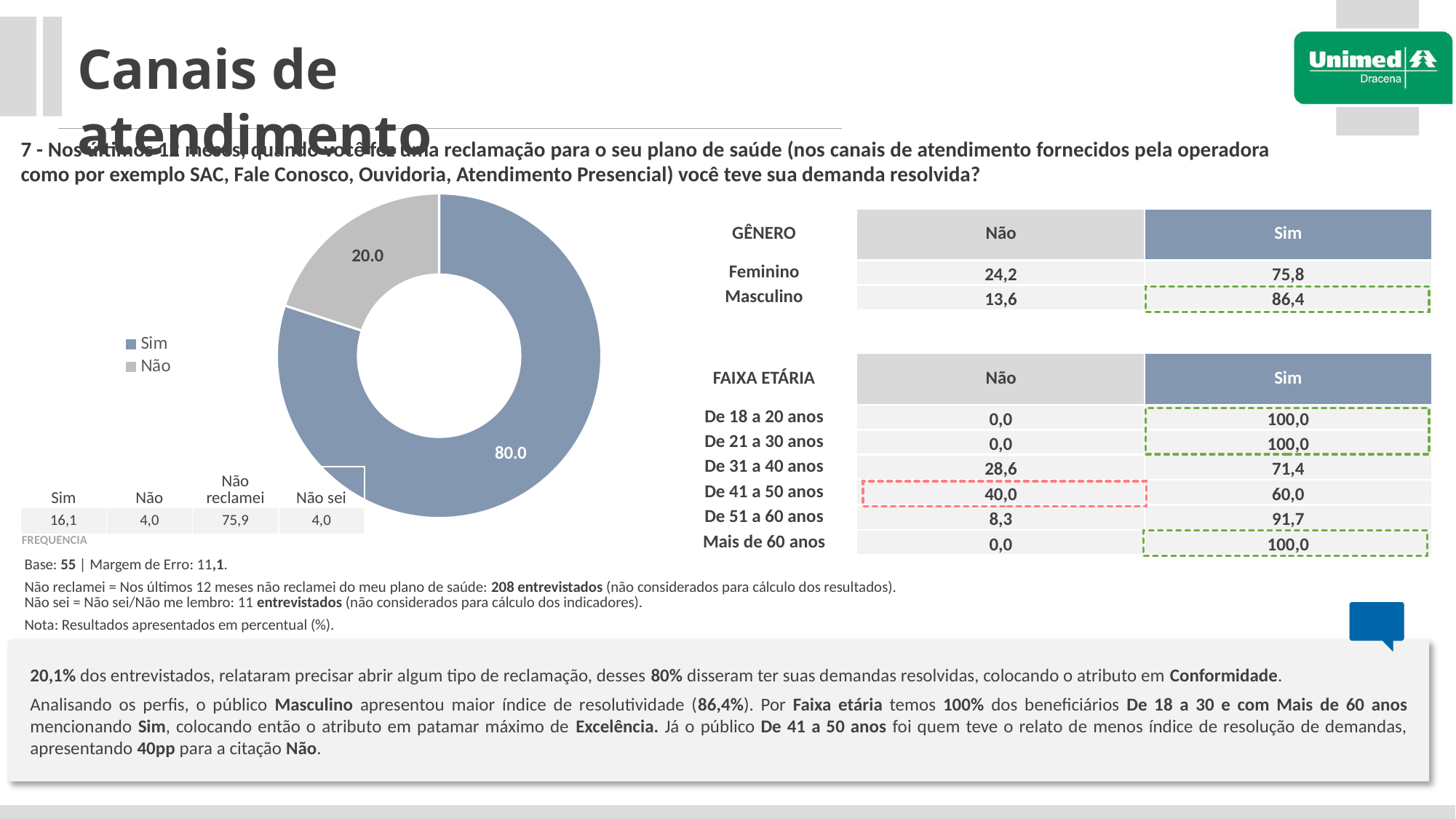
What is the difference between the Sim and Não values in the donut chart? 60.0 What is the value for Não in the donut chart? 20.0 What colour is the Sim slice in the donut chart? Blue-grey Which category has the smallest slice in the donut chart? Não What kind of chart is shown on the slide? Donut (pie) chart Which category has the largest slice in the donut chart? Sim What share of the donut chart does the Sim slice represent? 80.0 How many entries does the legend of the donut chart list? 2 What colour is the Não slice in the donut chart? Grey What is the value for Sim in the donut chart? 80.0 Which is larger in the donut chart, Sim or Não? Sim How many categories does the donut chart show? 2